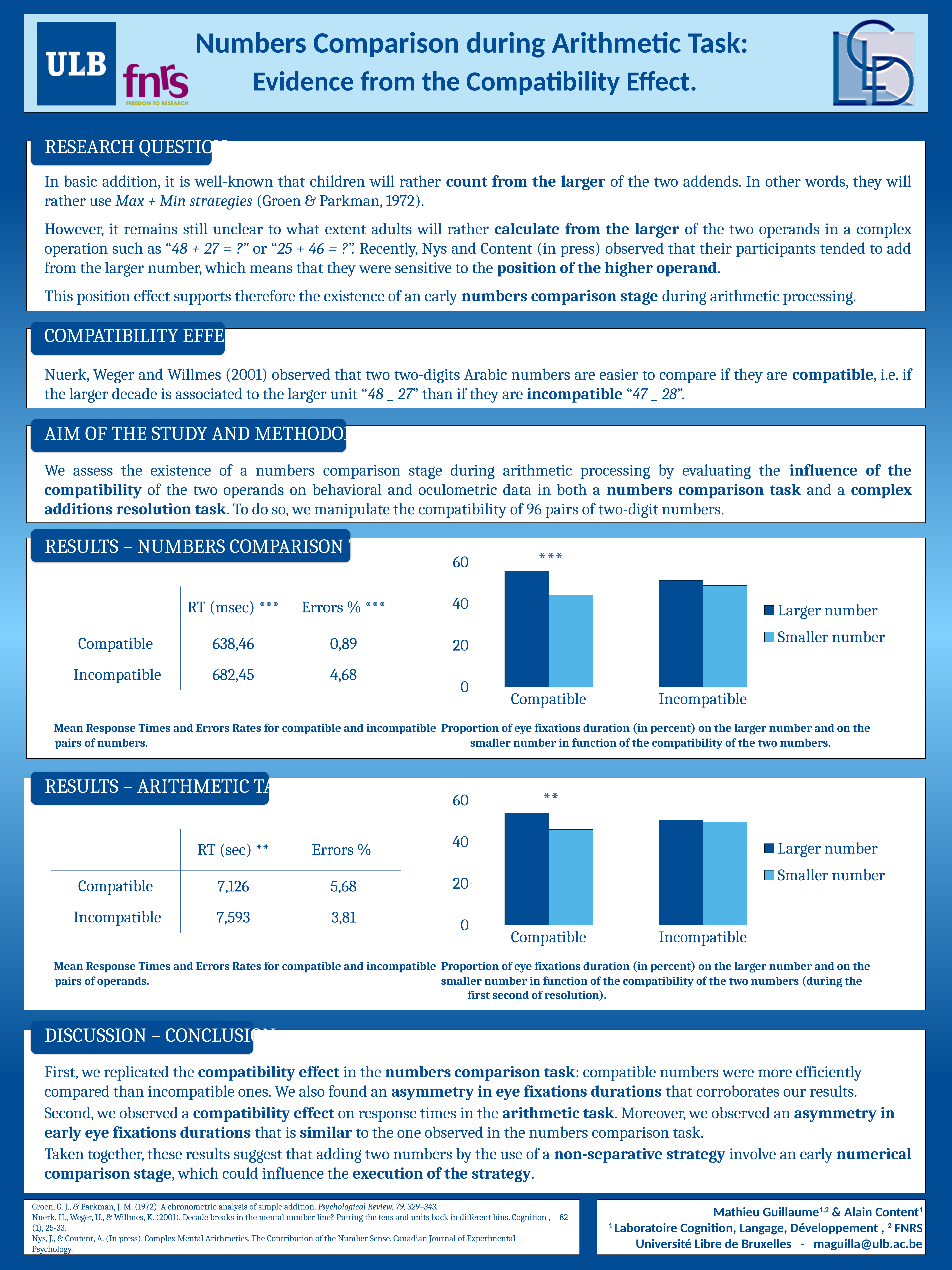
In the chart in the Results – Arithmetic Task section, which bar is the highest? Larger number for Compatible In the chart in the Results – Arithmetic Task section, what are the two legend entries? Larger number, Smaller number In the chart in the Results – Numbers Comparison section, which bar is the lowest? Smaller number for Compatible In the chart in the Results – Arithmetic Task section, which is larger for the Compatible category: Larger number or Smaller number? Larger number In the chart in the Results – Numbers Comparison section, what kind of chart is shown? bar chart In the chart in the Results – Numbers Comparison section, is the Smaller number value for Incompatible greater or less than 60? less In the chart in the Results – Numbers Comparison section, is the Larger number value for Compatible greater or less than 40? greater In the chart in the Results – Arithmetic Task section, which series is shown in the darker blue colour? Larger number In the chart in the Results – Numbers Comparison section, which is larger for the Compatible category: Larger number or Smaller number? Larger number In the chart in the Results – Numbers Comparison section, how many categories are shown on the x axis? 2 In the chart in the Results – Arithmetic Task section, is the Larger number value for Incompatible greater or less than 20? greater In the chart in the Results – Numbers Comparison section, how many series does the legend list? 2